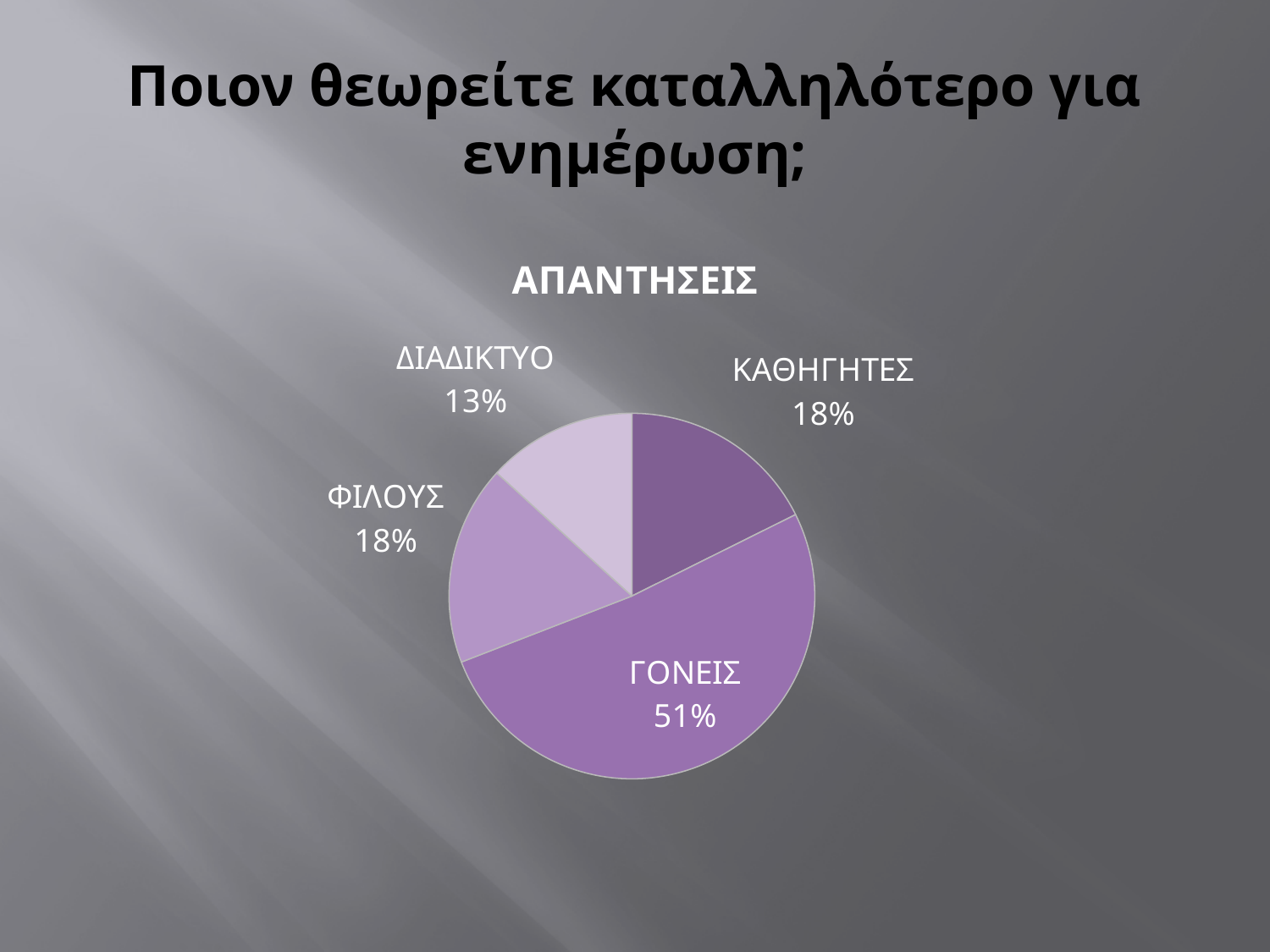
What kind of chart is shown on the slide? pie chart Which category has the largest slice of the pie? ΓΟΝΕΙΣ What is the difference in percentage points between ΓΟΝΕΙΣ and ΔΙΑΔΙΚΤΥΟ? 38 What is the difference in percentage points between ΦΙΛΟΥΣ and ΔΙΑΔΙΚΤΥΟ? 5 Which is larger, the share for ΓΟΝΕΙΣ or the share for ΚΑΘΗΓΗΤΕΣ? ΓΟΝΕΙΣ What share of the pie does ΔΙΑΔΙΚΤΥΟ have? 13% What share of the pie does ΚΑΘΗΓΗΤΕΣ have? 18% What is the title of the chart? ΑΠΑΝΤΗΣΕΙΣ Which category has the smallest slice of the pie? ΔΙΑΔΙΚΤΥΟ How many categories are shown in the pie chart? 4 What share of the pie does ΓΟΝΕΙΣ have? 51%